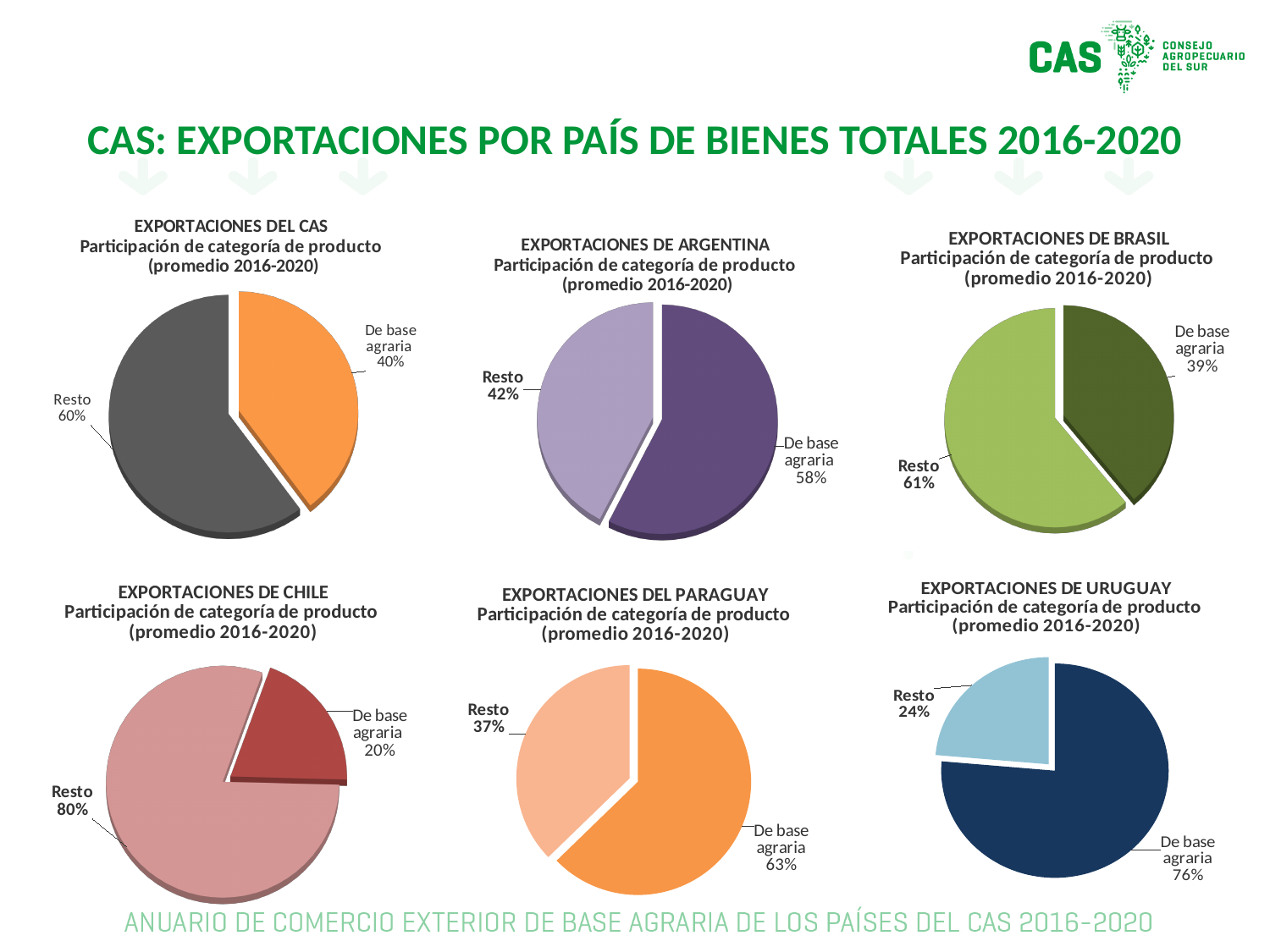
In the 'EXPORTACIONES DEL PARAGUAY' pie chart, which is larger, 'De base agraria' or 'Resto'? De base agraria In the 'EXPORTACIONES DE ARGENTINA' pie chart, what share does 'De base agraria' have? 58% In the 'EXPORTACIONES DEL CAS' pie chart, what share does 'De base agraria' have? 40% What kind of chart is used for 'EXPORTACIONES DE BRASIL'? Pie chart In the 'EXPORTACIONES DE CHILE' pie chart, which slice is the largest? Resto In the 'EXPORTACIONES DE URUGUAY' pie chart, what share does 'De base agraria' have? 76% In the 'EXPORTACIONES DEL CAS' pie chart, what is the value for 'Resto'? 60% In the 'EXPORTACIONES DE ARGENTINA' pie chart, what is the difference between 'De base agraria' and 'Resto'? 16% In the 'EXPORTACIONES DE BRASIL' pie chart, what is the value for 'Resto'? 61% In the 'EXPORTACIONES DE URUGUAY' pie chart, which slice is the smallest? Resto In the 'EXPORTACIONES DEL PARAGUAY' pie chart, what is the value for 'Resto'? 37%